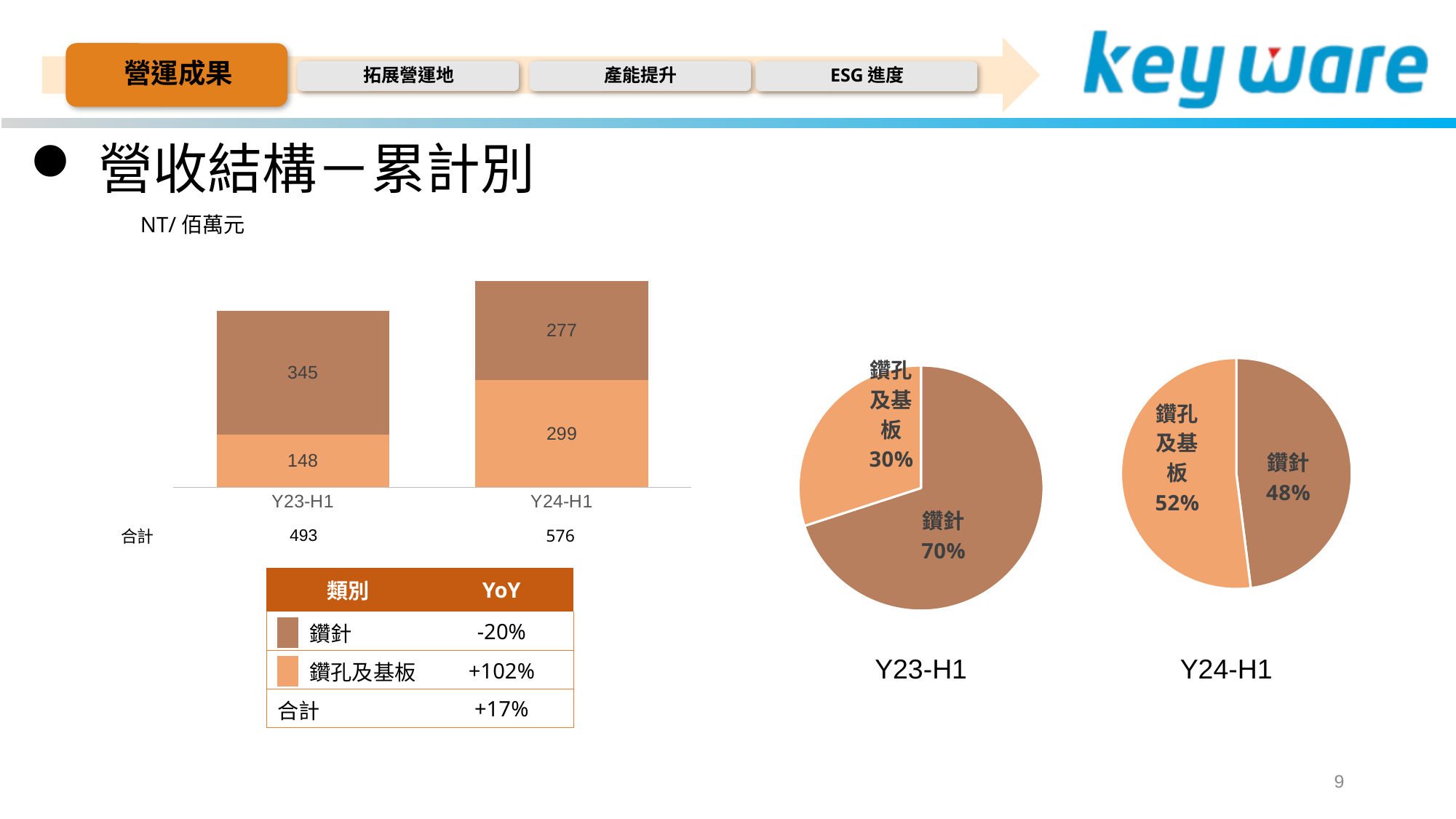
In the stacked bar chart, which period has the larger 鑽針 value, Y23-H1 or Y24-H1? Y23-H1 In the stacked bar chart, what is the difference between the 鑽孔及基板 values for Y24-H1 and Y23-H1? 151 In the Y23-H1 pie chart, what share does 鑽針 have? 70% In the Y24-H1 pie chart, which slice is larger, 鑽針 or 鑽孔及基板? 鑽孔及基板 In the stacked bar chart, what is the total of the Y24-H1 bar? 576 What unit is stated for the values on the slide? NT/ 佰萬元 In the stacked bar chart, what is the value of 鑽孔及基板 for Y24-H1? 299 What type of chart is used on the left side of the slide to show 345, 148, 277 and 299? Stacked bar chart In the stacked bar chart, what is the total of the Y23-H1 bar? 493 In the stacked bar chart, what is the value of 鑽針 for Y23-H1? 345 In the Y24-H1 pie chart, what share does 鑽孔及基板 have? 52% How many periods (bars) are shown in the stacked bar chart? 2